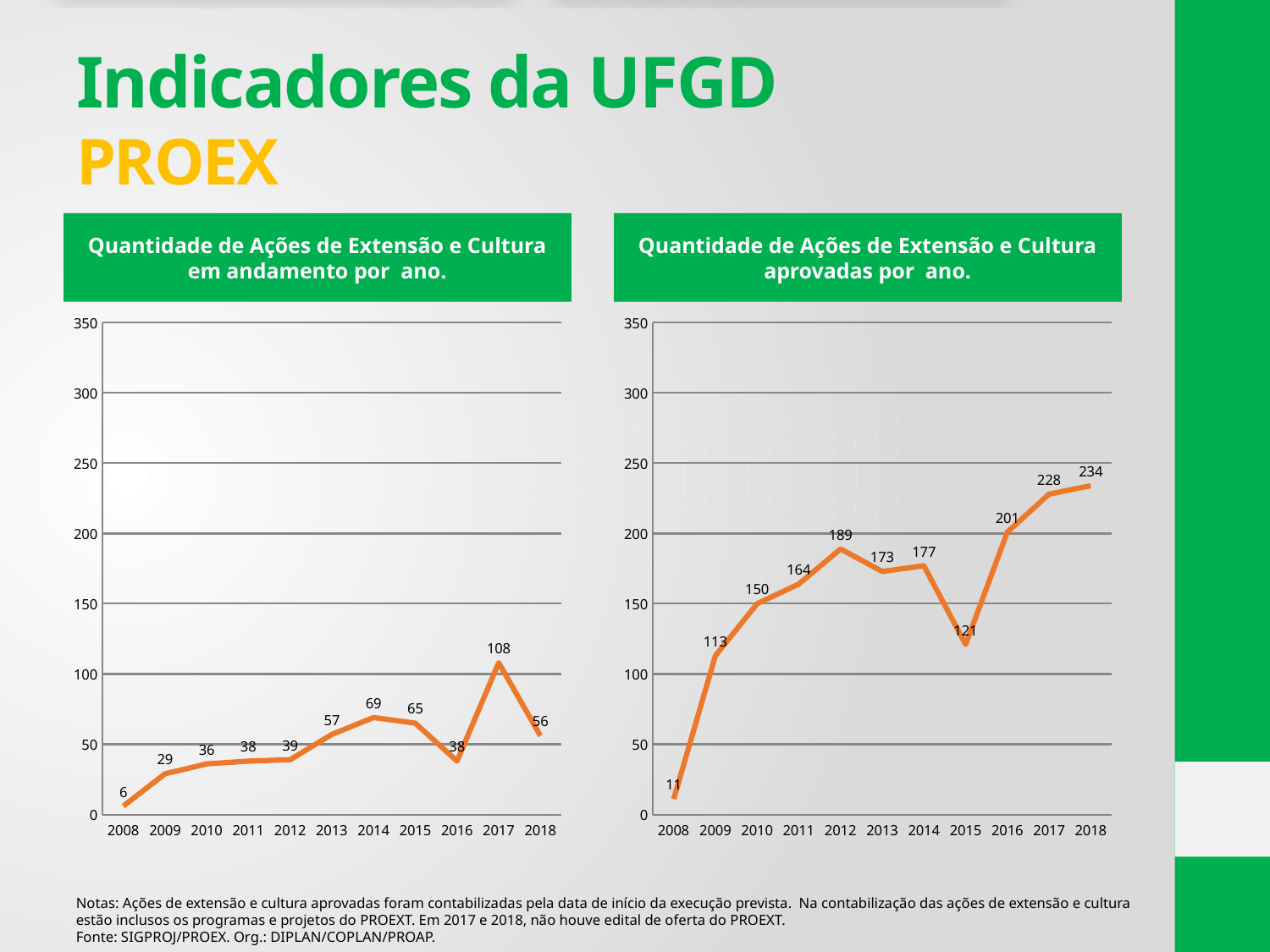
In the chart 'Quantidade de Ações de Extensão e Cultura em andamento por ano', what is the value for 2017? 108 In the chart 'Quantidade de Ações de Extensão e Cultura aprovadas por ano', do the values rise or fall from 2015 to 2018? Rise In the chart 'Quantidade de Ações de Extensão e Cultura aprovadas por ano', what is the value for 2015? 121 In the chart 'Quantidade de Ações de Extensão e Cultura em andamento por ano', which year has the lowest value? 2008 In the chart 'Quantidade de Ações de Extensão e Cultura em andamento por ano', which is larger, the value for 2014 or the value for 2016? 2014 In the chart 'Quantidade de Ações de Extensão e Cultura em andamento por ano', what is the value for 2013? 57 How many years are plotted in the chart 'Quantidade de Ações de Extensão e Cultura aprovadas por ano'? 11 In the chart 'Quantidade de Ações de Extensão e Cultura aprovadas por ano', what is the difference between the values for 2018 and 2008? 223 In the chart 'Quantidade de Ações de Extensão e Cultura aprovadas por ano', is the value for 2016 greater or less than 150? greater In the chart 'Quantidade de Ações de Extensão e Cultura aprovadas por ano', which year has the highest value? 2018 In the chart 'Quantidade de Ações de Extensão e Cultura em andamento por ano', what is the difference between the values for 2017 and 2018? 52 What kind of chart is 'Quantidade de Ações de Extensão e Cultura em andamento por ano'? Line chart